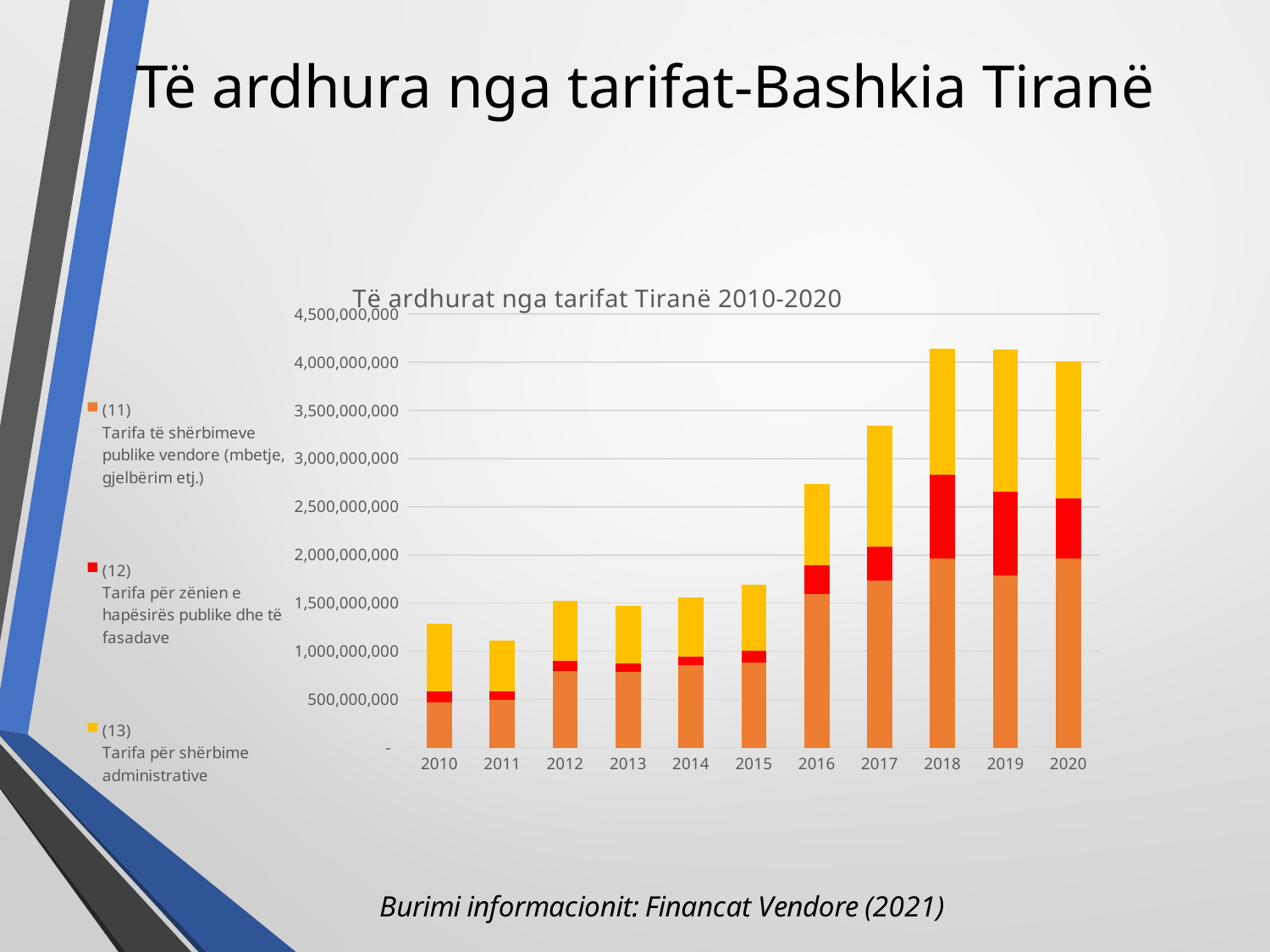
Which year has the larger total bar, 2016 or 2017? 2017 What is the title of the chart? Të ardhurat nga tarifat Tiranë 2010-2020 What kind of chart is shown on the slide? Stacked bar chart How many series does the legend list? 3 Is the total value for 2015 greater or less than 2,000,000,000? less Which year has the lowest total bar in the chart? 2011 Do the total values generally rise or fall from 2010 to 2018? rise Is the total value for 2016 greater or less than 2,500,000,000? greater Is the total value for 2010 greater or less than 1,500,000,000? less How many years are shown along the x axis of the chart? 11 Which colour represents the series '(13) Tarifa për shërbime administrative'? Yellow